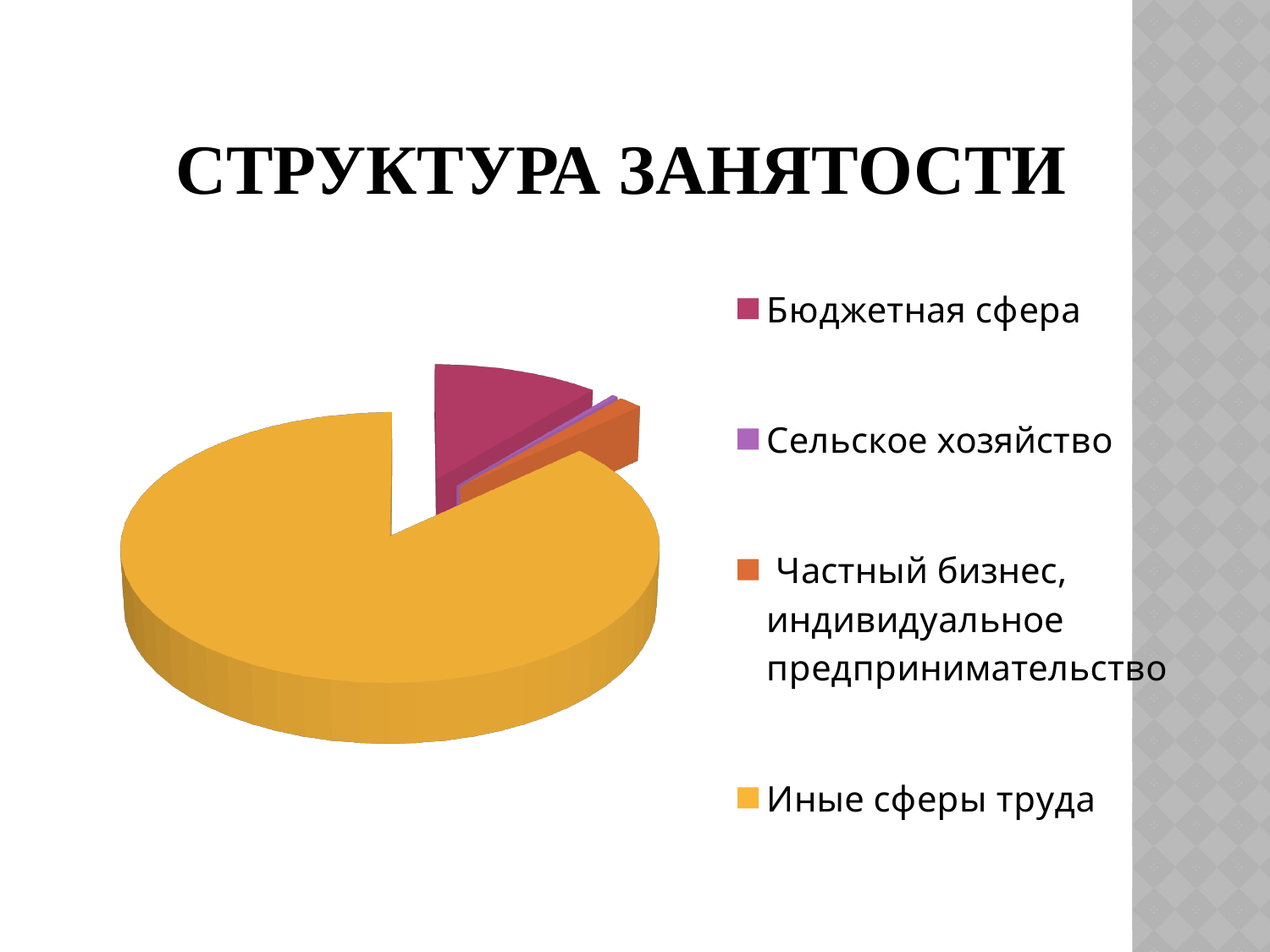
Which is larger: the share for Иные сферы труда or the share for Частный бизнес, индивидуальное предпринимательство? Иные сферы труда Which category has the largest share of the pie? Иные сферы труда What is the title of the slide with the pie chart? СТРУКТУРА ЗАНЯТОСТИ Which is larger: the share for Бюджетная сфера or the share for Частный бизнес, индивидуальное предпринимательство? Бюджетная сфера Which is larger: the share for Бюджетная сфера or the share for Сельское хозяйство? Бюджетная сфера What colour is the slice for Иные сферы труда? Yellow How many categories does the pie chart show? 4 Which category has the smallest share of the pie? Сельское хозяйство What kind of chart is shown on the slide? Pie chart